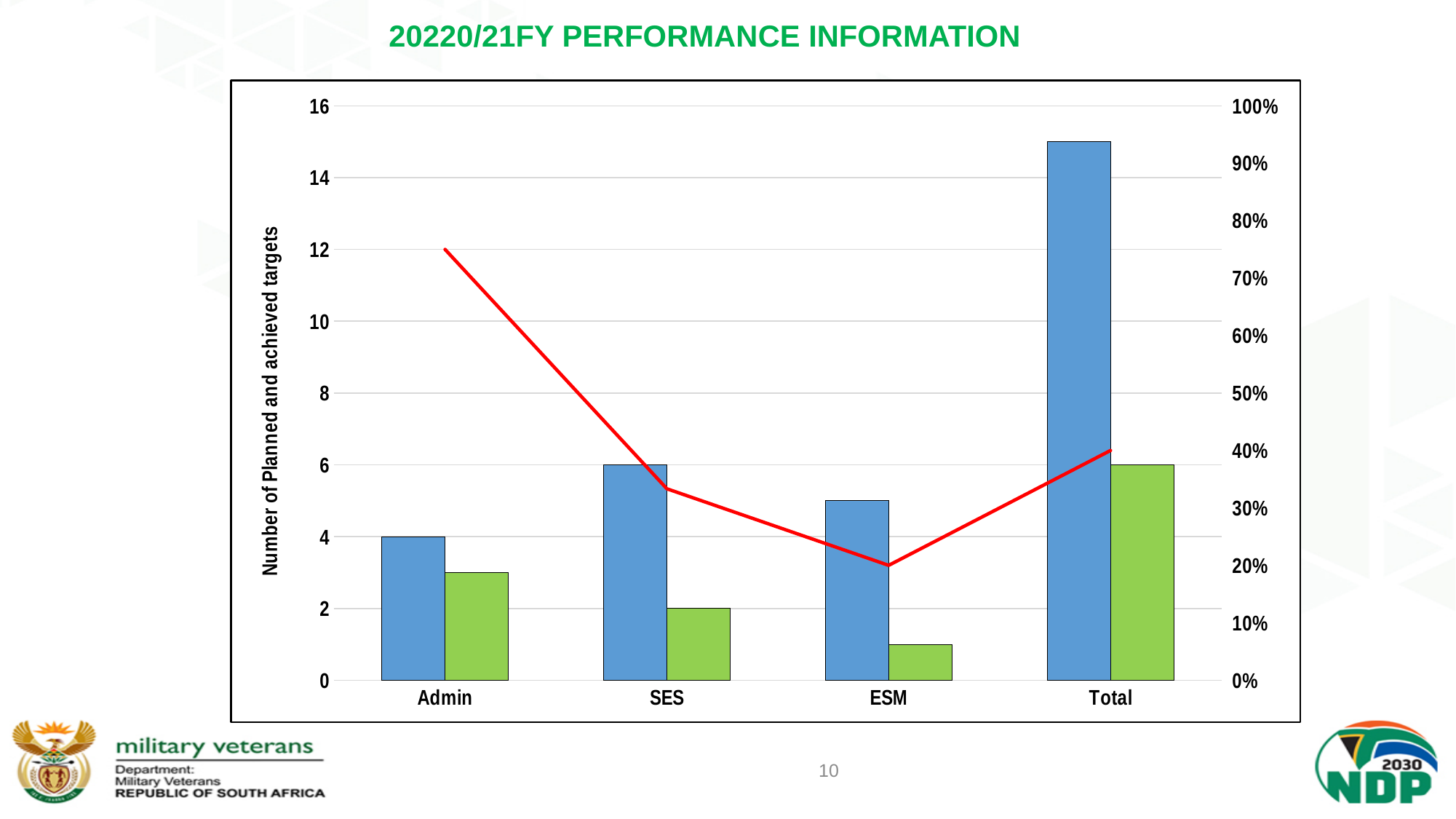
Which category has the tallest blue bar? Total What is the value of the red line at ESM on the right-hand axis? 20% What is the value of the blue bar for SES? 6 What kind of chart is shown on the slide? bar chart with a line Which category has the shortest green bar? ESM What is the value of the green bar for Total? 6 What is the difference between the blue bar and the green bar for SES? 4 How many categories are shown on the x axis? 4 Does the red line rise or fall from Admin to ESM? fall What is the value of the green bar for SES? 2 Is the blue bar for Total greater or less than 14? greater What is the value of the blue bar for Admin? 4